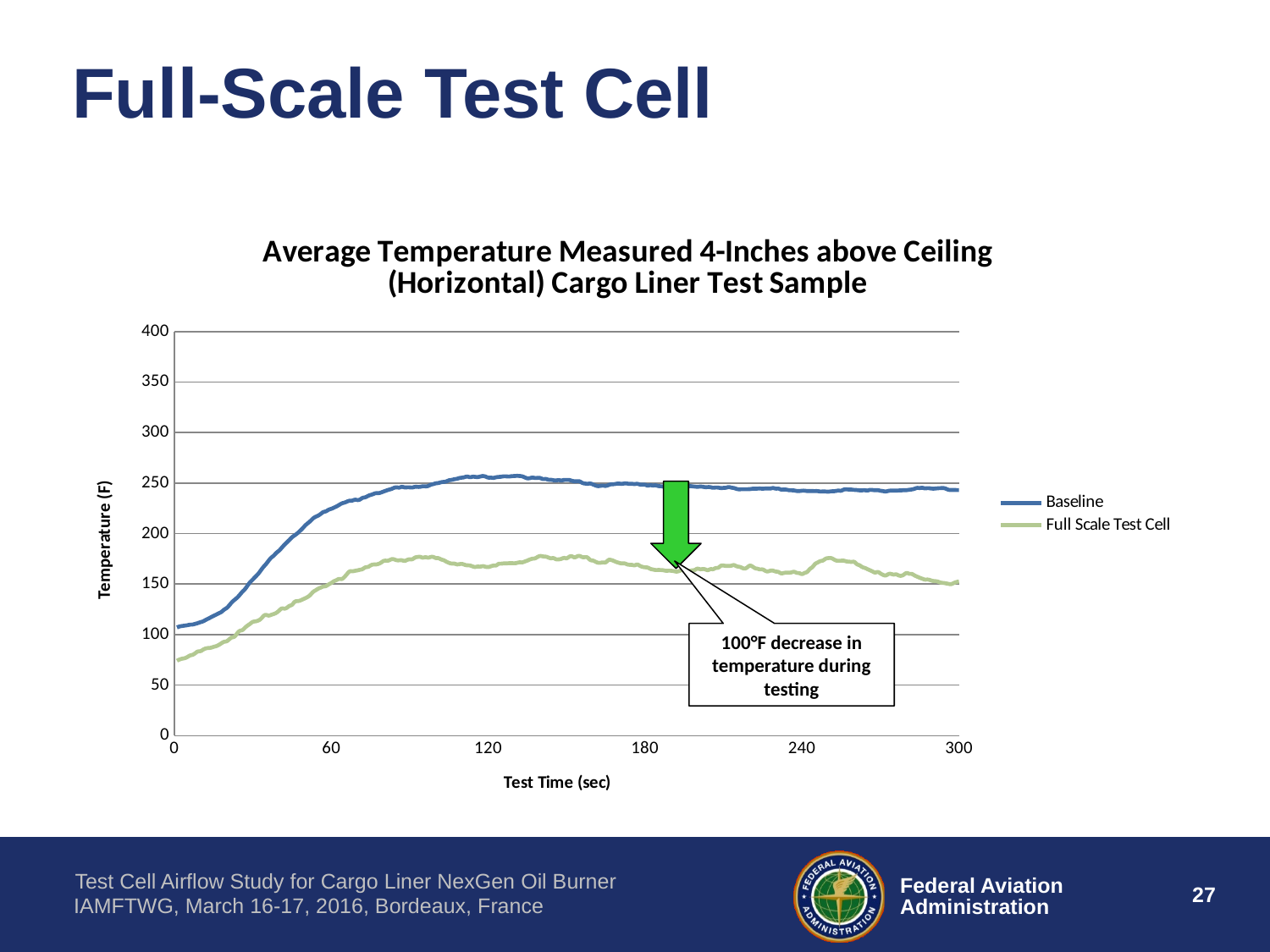
Is the Full Scale Test Cell temperature at 0 seconds greater or less than 100? less Is the Baseline temperature at 0 seconds greater or less than 150? less Which series shows the higher temperature at 180 seconds, Baseline or Full Scale Test Cell? Baseline What kind of chart is shown on the slide? line chart Is the Full Scale Test Cell temperature at 120 seconds greater or less than 200? less Which series reaches the highest temperature on the chart? Baseline What is the title of the chart's x axis? Test Time (sec) How many series does the chart legend list? 2 What are the two series named in the chart legend? Baseline and Full Scale Test Cell Does the Baseline temperature rise or fall between 0 and 60 seconds? rise